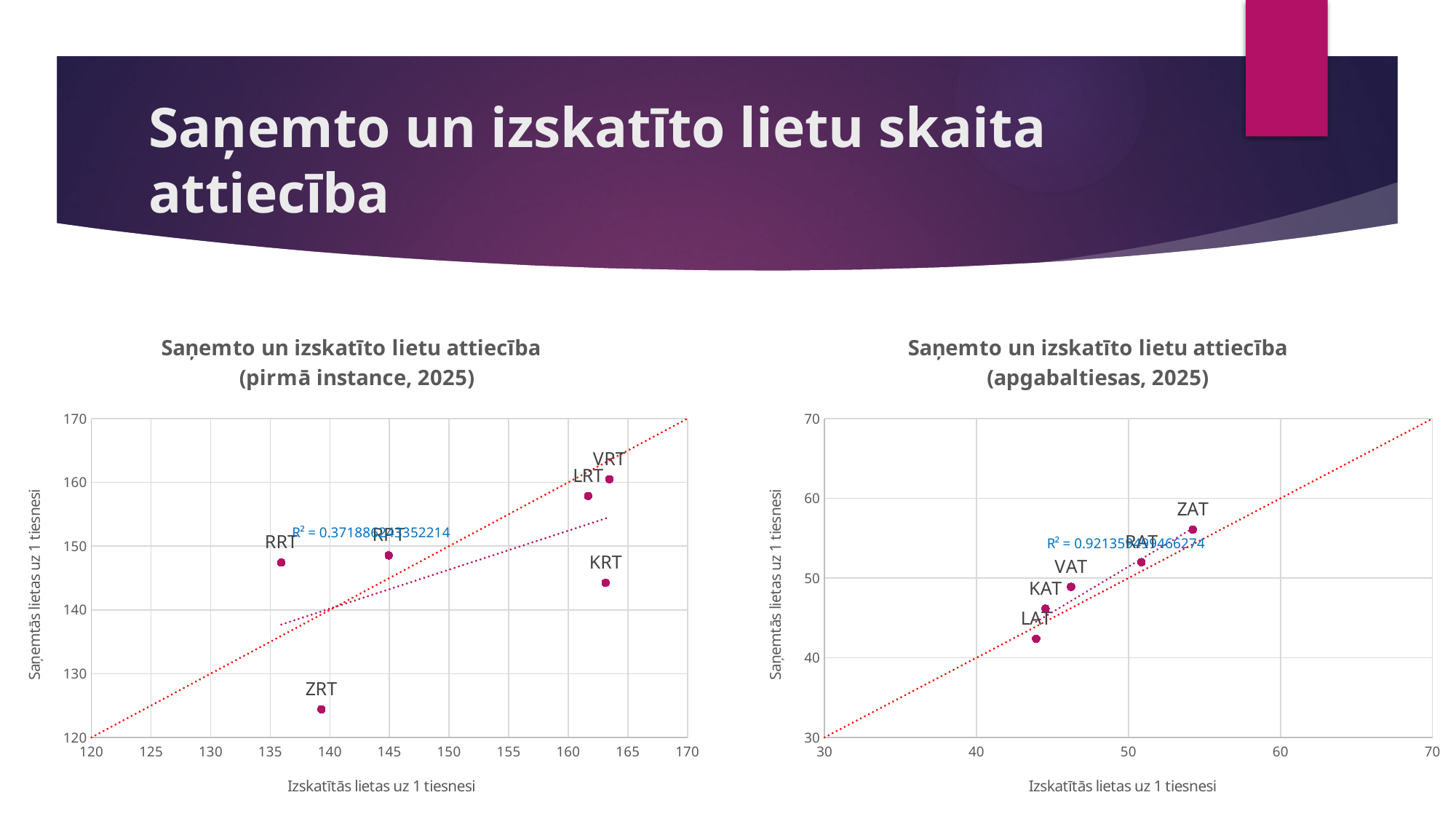
On the left chart (pirmā instance, 2025), is the horizontal-axis value for RRT greater or less than 140? less How many labelled data points are plotted on the left chart (pirmā instance, 2025)? 6 On the left chart (pirmā instance, 2025), is the vertical-axis value for KRT greater or less than 150? less On the right chart (apgabaltiesas, 2025), which court has the lowest value on the vertical axis (Saņemtās lietas uz 1 tiesnesi)? LAT How many labelled data points are plotted on the right chart (apgabaltiesas, 2025)? 5 On the left chart (pirmā instance, 2025), which has the larger vertical-axis value, KRT or ZRT? KRT On the right chart (apgabaltiesas, 2025), is the horizontal-axis value for LAT greater or less than 50? less What is the horizontal axis title of the right chart (apgabaltiesas, 2025)? Izskatītās lietas uz 1 tiesnesi What kind of chart is the left chart, 'Saņemto un izskatīto lietu attiecība (pirmā instance, 2025)'? scatter chart On the left chart (pirmā instance, 2025), which court has the lowest value on the vertical axis (Saņemtās lietas uz 1 tiesnesi)? ZRT On the right chart (apgabaltiesas, 2025), which court has the highest value on the vertical axis (Saņemtās lietas uz 1 tiesnesi)? ZAT